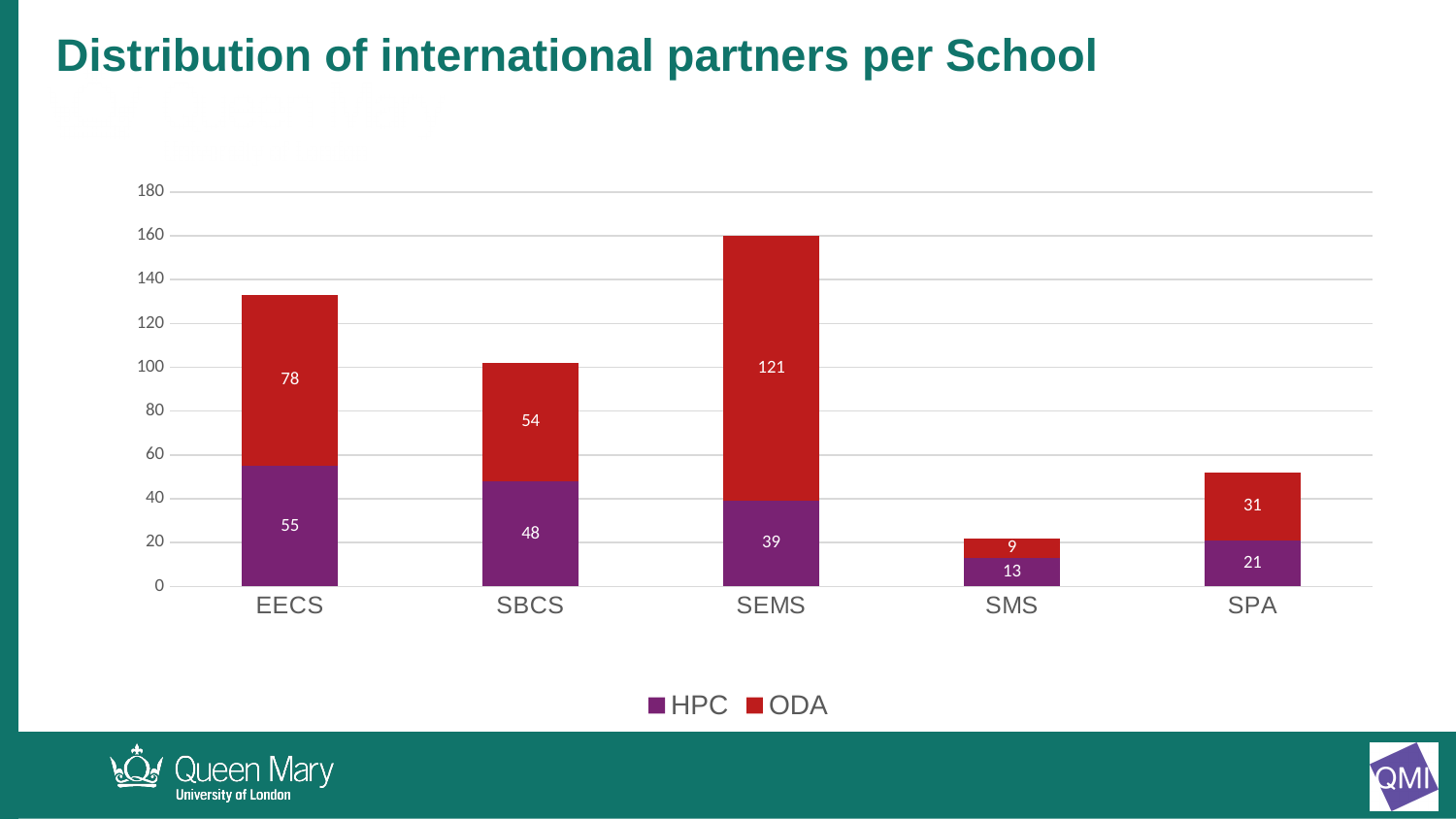
Which school has the highest ODA value? SEMS How many series does the legend list? 2 Which school has the lowest HPC value? SMS How many schools are shown on the x axis? 5 What is the total of the stacked bar for SEMS? 160 What kind of chart is shown? Stacked bar chart What is the ODA value for SMS? 9 What is the ODA value for SEMS? 121 What is the difference between the ODA values for EECS and SBCS? 24 What is the HPC value for EECS? 55 What is the total of the stacked bar for SPA? 52 Which is larger, the HPC value for SBCS or the HPC value for SEMS? SBCS